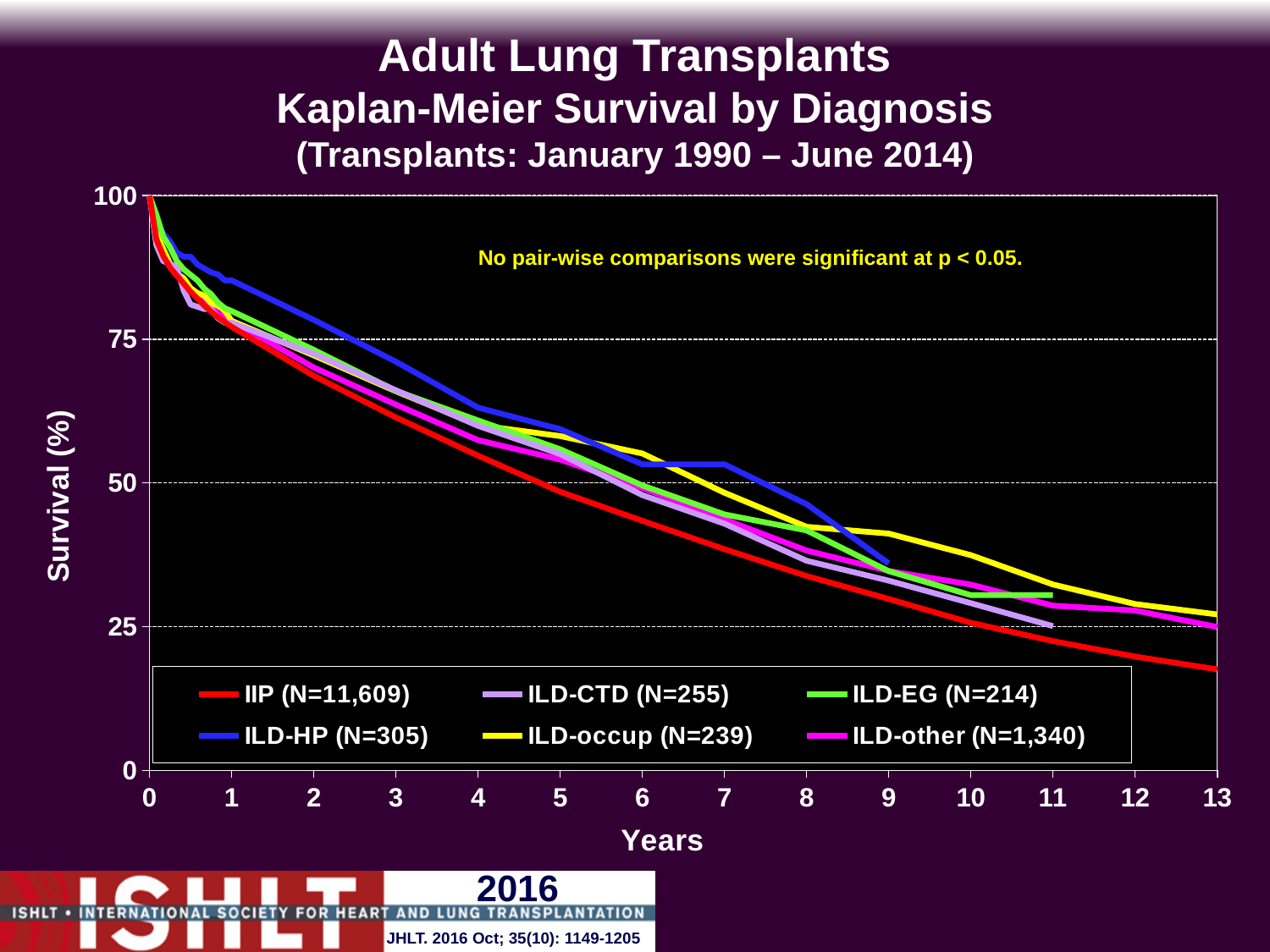
At year 7, which has higher survival: ILD-HP or IIP? ILD-HP Which series has the lowest survival at year 10? IIP Is the survival value for ILD-occup at year 10 greater or less than 25? greater What is the survival value for all series at year 0? 100 Do the survival curves rise or fall as the years increase? fall How many series does the legend list? 6 What is the label of the y axis? Survival (%) Is the survival value for ILD-HP at year 4 greater or less than 50? greater What is the N shown in the legend for IIP? 11,609 Is the survival value for IIP at year 8 greater or less than 50? less Which series has the highest survival at year 10? ILD-occup What kind of chart is shown on the slide? line chart